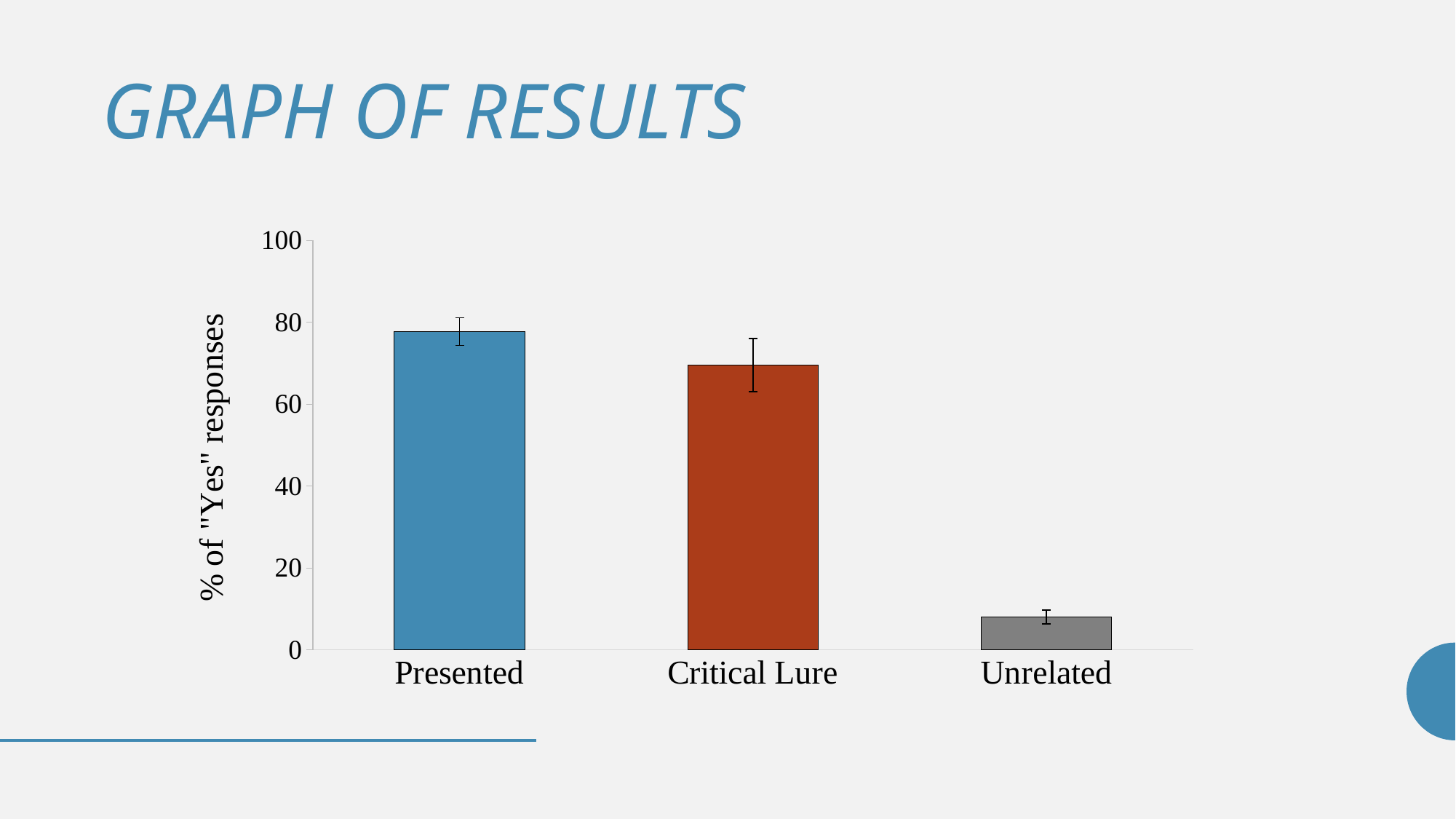
Do the values rise or fall moving from left to right along the x axis? fall Is the value for Critical Lure greater or less than 80? less Which is larger, the value for Presented or the value for Critical Lure? Presented What kind of chart is shown on the slide? bar chart Which is larger, the value for Critical Lure or the value for Unrelated? Critical Lure Is the value for Unrelated greater or less than 20? less Which category has the highest % of "Yes" responses? Presented Is the value for Presented greater or less than 60? greater What is the label on the y axis of the chart? % of "Yes" responses How many categories are shown on the x axis of the chart? 3 Which category has the lowest % of "Yes" responses? Unrelated